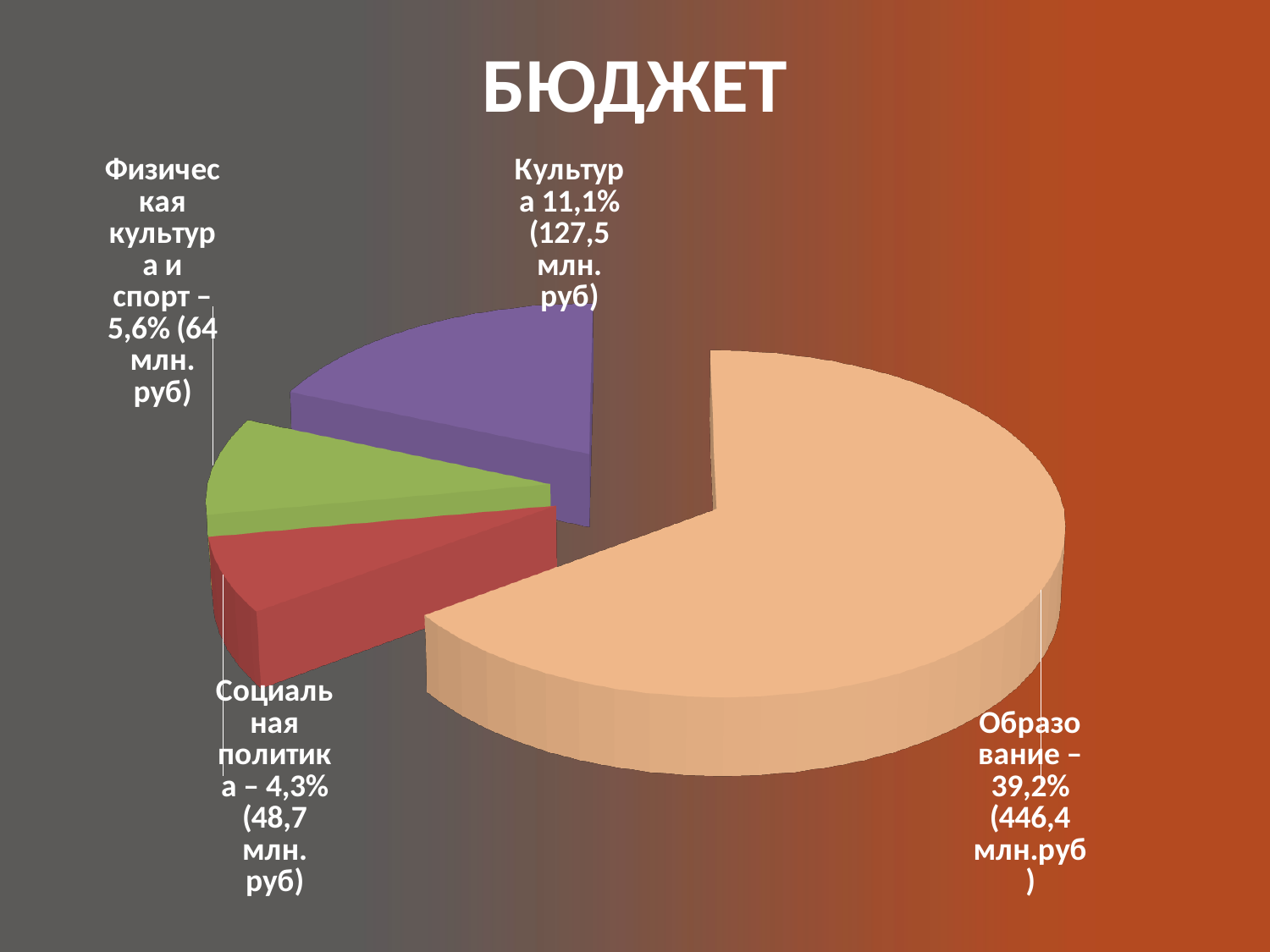
What is the title of the chart? БЮДЖЕТ What percentage is shown for Физическая культура и спорт? 5,6% Which is larger, the amount for Культура or the amount for Физическая культура и спорт? Культура What kind of chart is shown on the slide? Pie chart What is the difference in percentage points between Физическая культура и спорт and Социальная политика? 1,3% How many slices does the pie chart have? 4 What is the difference in million rubles between Образование and Культура? 318,9 млн. руб What percentage is shown for Культура? 11,1% Which category has the smallest slice of the pie? Социальная политика Which category has the largest slice of the pie? Образование What amount in million rubles is shown for Социальная политика? 48,7 млн. руб What amount in million rubles is shown for Образование? 446,4 млн.руб